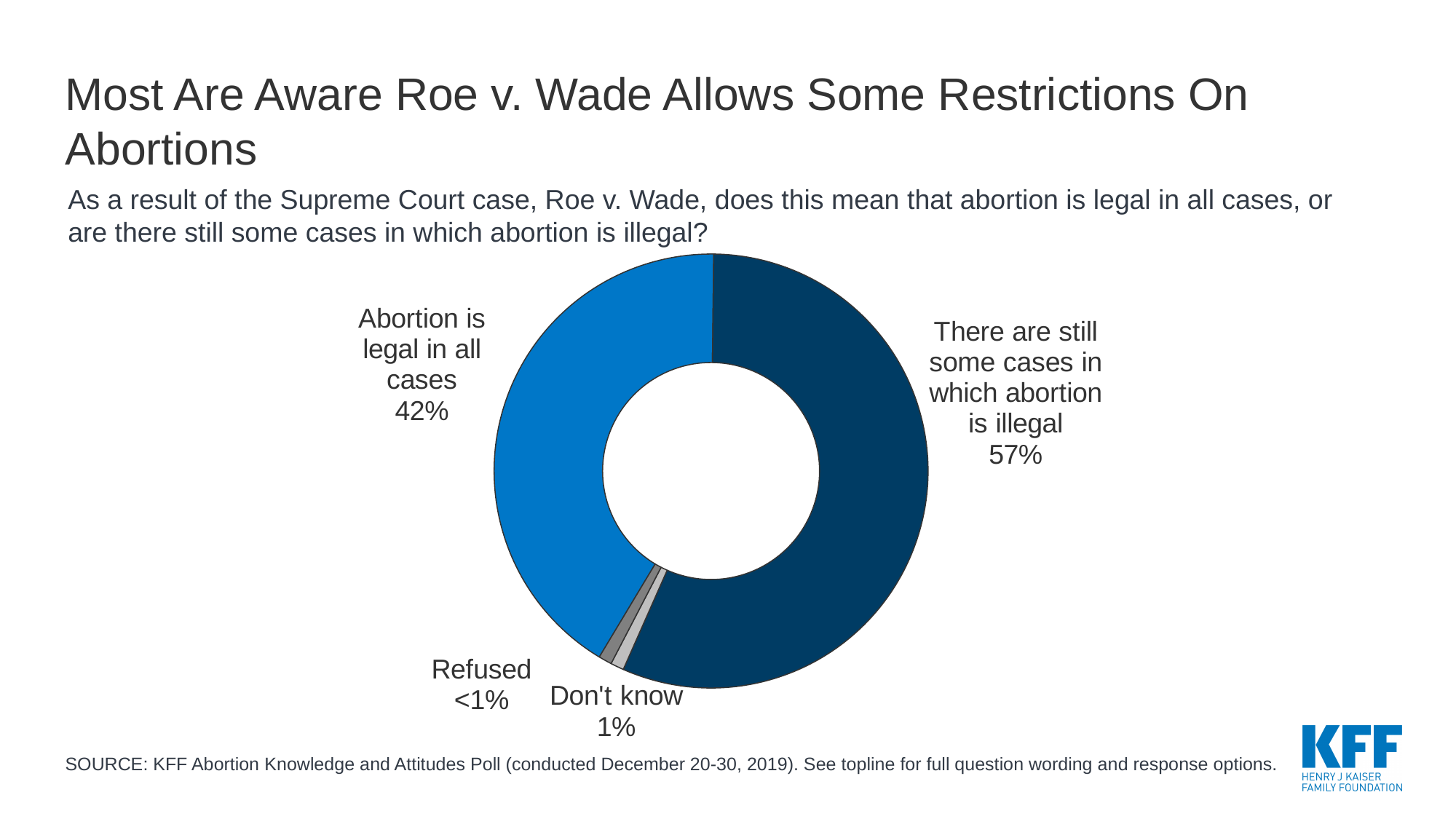
What value is shown for the "Refused" slice? <1% How many response categories are shown in the chart? 4 What is the title of the slide? Most Are Aware Roe v. Wade Allows Some Restrictions On Abortions What is the difference in percentage points between "There are still some cases in which abortion is illegal" and "Abortion is legal in all cases"? 15 What colour is the slice for "Abortion is legal in all cases"? Light blue What percentage of respondents answered "Don't know"? 1% Which response has the smallest share of the chart? Refused Which is larger: the share for "Abortion is legal in all cases" or the share for "There are still some cases in which abortion is illegal"? There are still some cases in which abortion is illegal What kind of chart is shown on the slide? Pie chart (donut) What percentage of respondents said there are still some cases in which abortion is illegal? 57% Which response has the largest share of the chart? There are still some cases in which abortion is illegal What percentage of respondents said abortion is legal in all cases? 42%